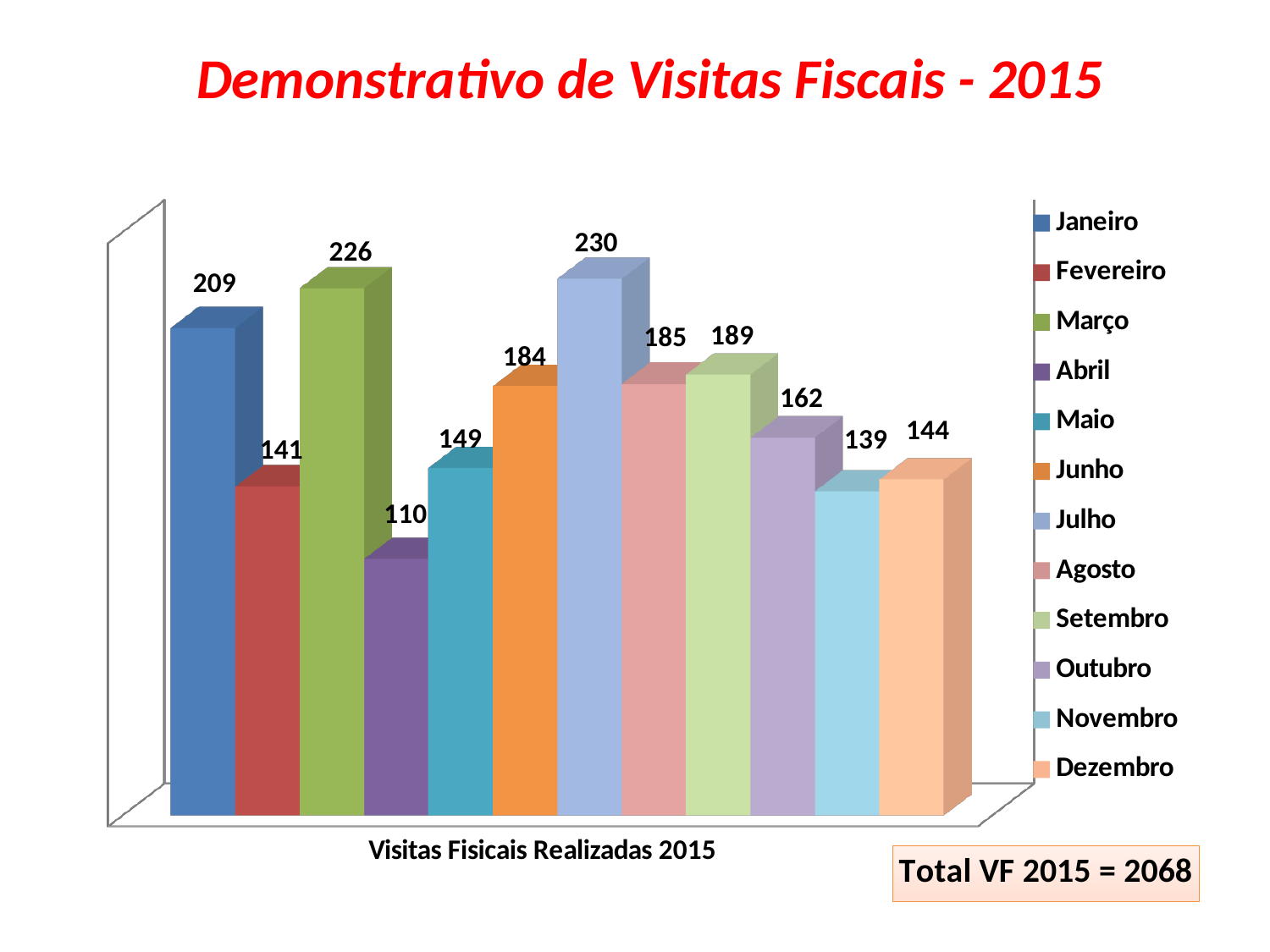
What is the value for Julho? 230 What is the value for Janeiro? 209 Which month has the lowest value? Abril Which month has the highest value? Julho Which is larger, the value for Agosto or the value for Setembro? Setembro What kind of chart is shown on the slide? Bar chart How many months are plotted in the chart? 12 How many entries does the legend list? 12 What is the difference between the values for Março and Fevereiro? 85 What is the value for Dezembro? 144 What is the value for Abril? 110 What is the total of visits for 2015 shown on the slide? 2068